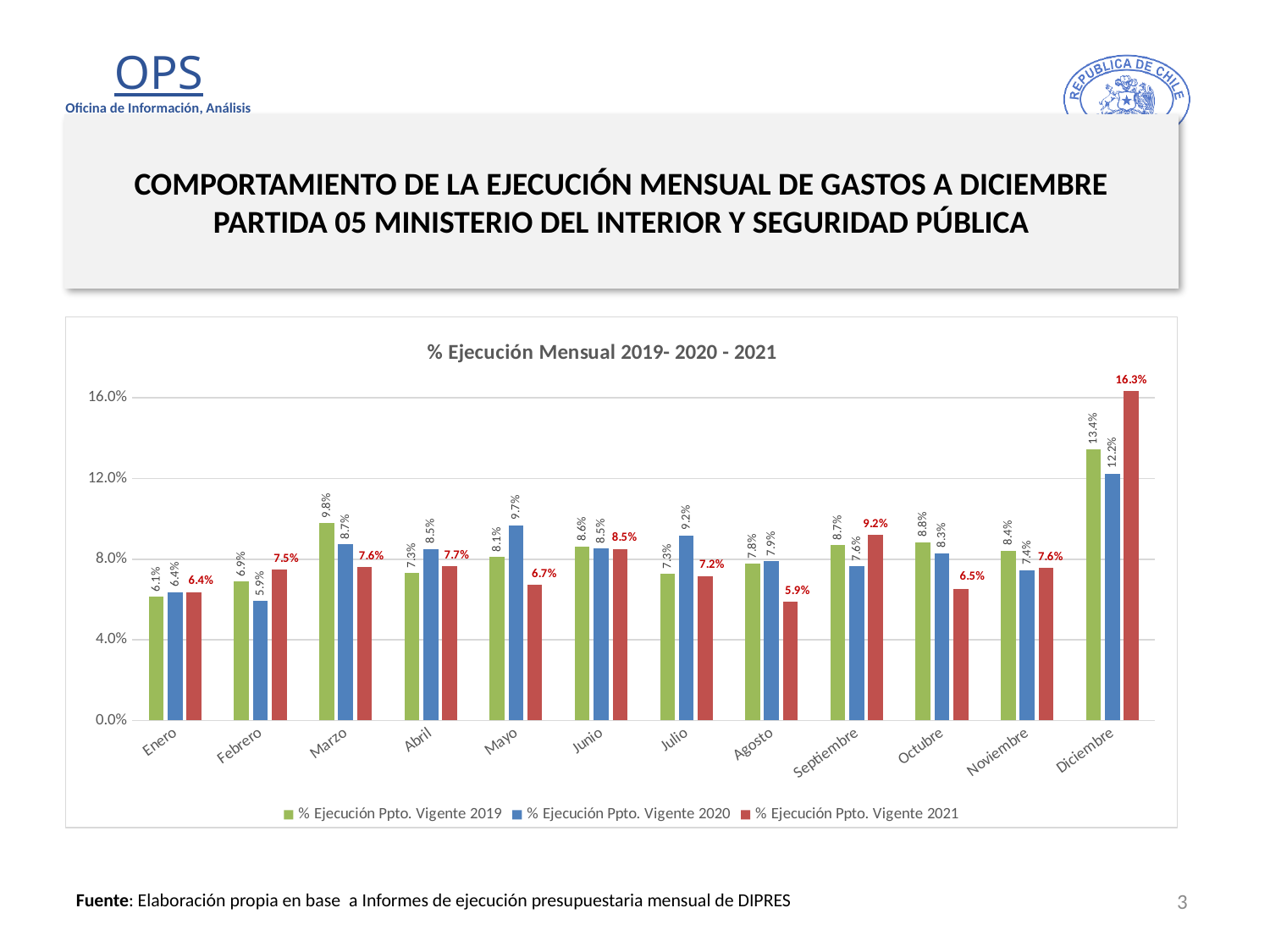
For Agosto, which series has the larger value: % Ejecución Ppto. Vigente 2020 or % Ejecución Ppto. Vigente 2021? % Ejecución Ppto. Vigente 2020 What is the title of the chart? % Ejecución Mensual 2019- 2020 - 2021 Is the value for Diciembre in the % Ejecución Ppto. Vigente 2020 series greater or less than 12.0%? greater How many months are shown on the x axis of the chart? 12 What is the value for Diciembre in the % Ejecución Ppto. Vigente 2021 series? 16.3% What is the difference between the 2021 and 2019 values for Diciembre? 2.9% Which month has the lowest value in the % Ejecución Ppto. Vigente 2021 series? Agosto How many series does the legend list? 3 What kind of chart is shown on the slide? Bar chart Which month has the highest value in the % Ejecución Ppto. Vigente 2021 series? Diciembre What is the value for Marzo in the % Ejecución Ppto. Vigente 2019 series? 9.8% What is the value for Mayo in the % Ejecución Ppto. Vigente 2020 series? 9.7%